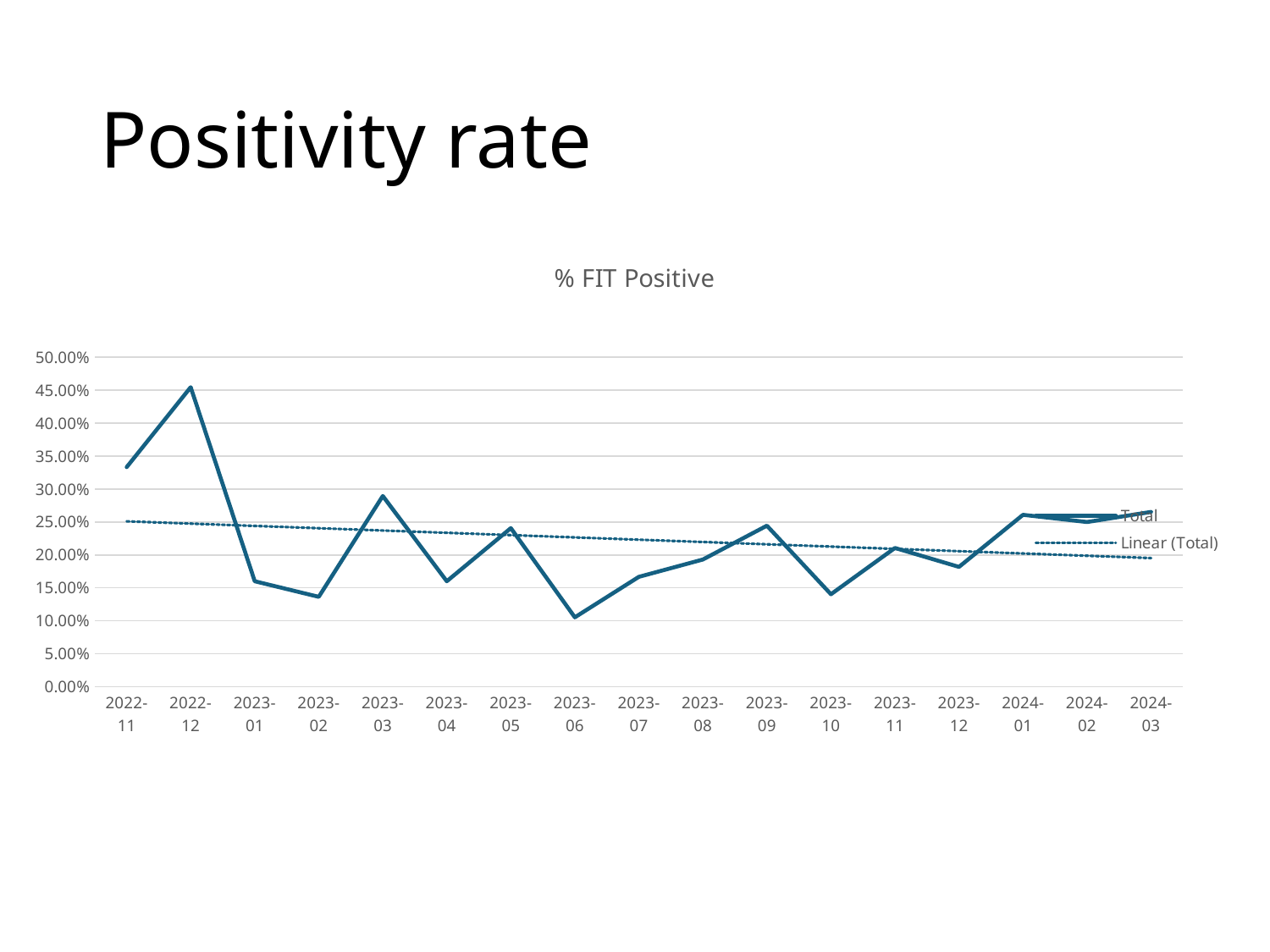
What is the title of the chart? % FIT Positive Does the Linear (Total) trendline rise or fall from left to right? fall Is the value for 2022-12 greater or less than 40.00%? greater Is the value for 2023-10 greater or less than 20.00%? less Which is larger, the value for 2023-03 or the value for 2023-04? 2023-03 Is the value for 2022-11 greater or less than 30.00%? greater How many entries does the chart legend list? 2 How many months are plotted along the x axis? 17 Which month has the lowest % FIT Positive value? 2023-06 What kind of chart is shown on the slide? line chart Which month has the highest % FIT Positive value? 2022-12